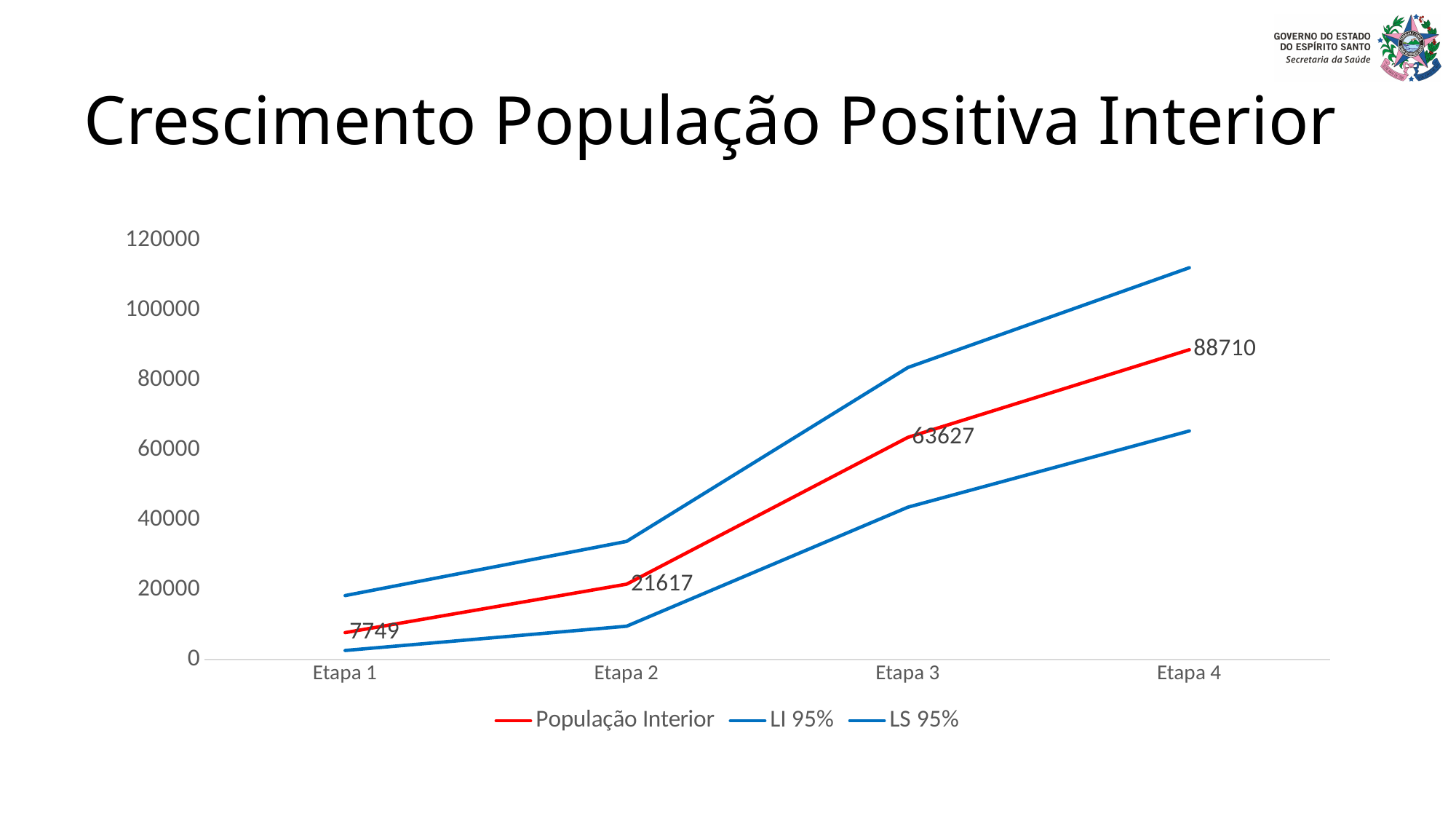
What is the value of População Interior at Etapa 4? 88710 At which Etapa is População Interior lowest? Etapa 1 At which Etapa is População Interior highest? Etapa 4 Is the value of LS 95% at Etapa 4 greater or less than 100000? greater What kind of chart is shown on the slide? line chart How many series does the legend list? 3 Which is larger for População Interior: Etapa 2 or Etapa 3? Etapa 3 What is the difference between População Interior at Etapa 4 and at Etapa 3? 25083 What is the value of População Interior at Etapa 3? 63627 What is the value of População Interior at Etapa 1? 7749 What is the value of População Interior at Etapa 2? 21617 Is the value of LI 95% at Etapa 2 greater or less than 20000? less